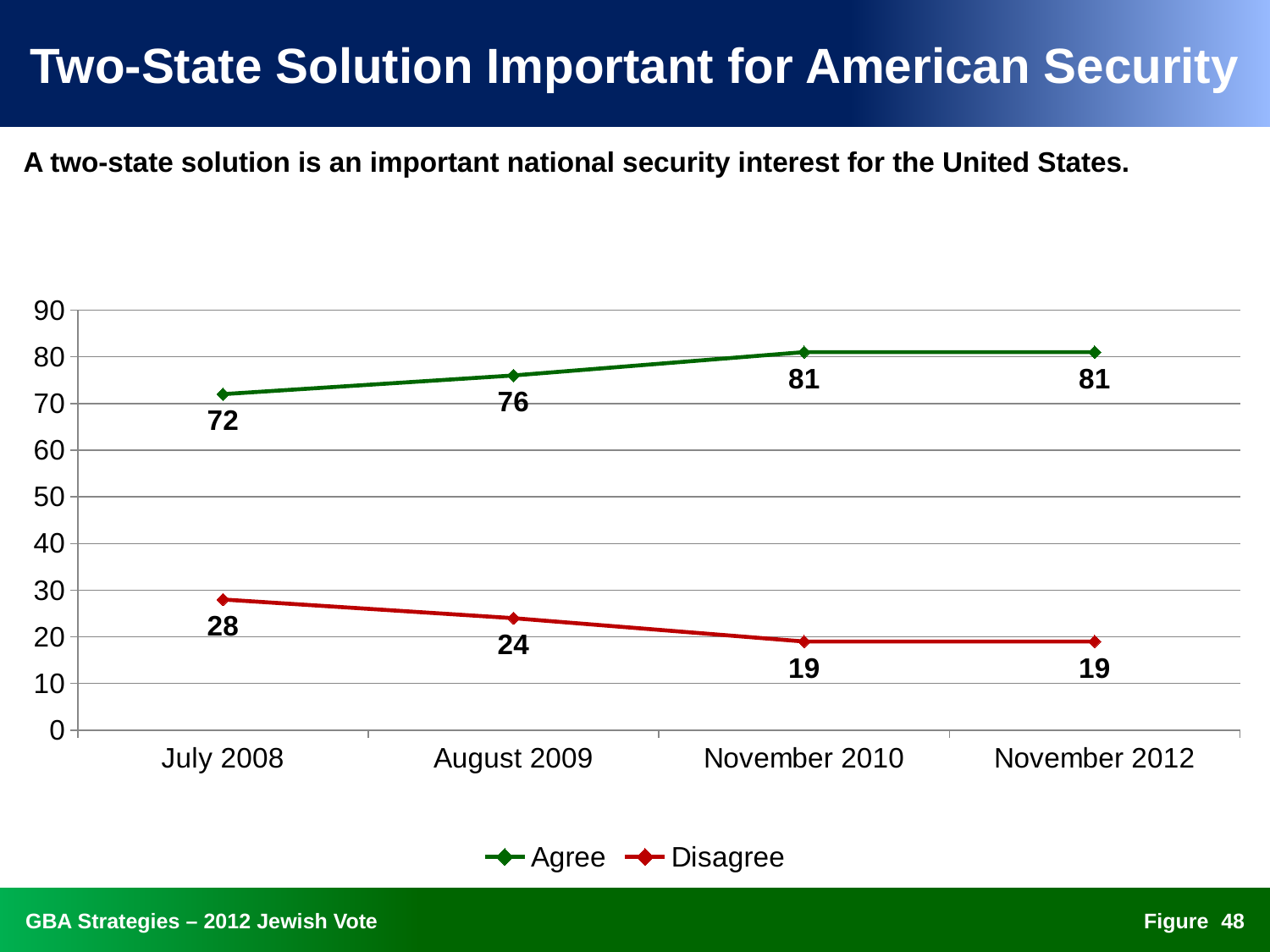
In which survey wave is the Agree value lowest? July 2008 In which survey wave is the Disagree value lowest? November 2010 and November 2012 Does the Disagree series rise or fall from July 2008 to November 2010? Fall What is the Disagree value for August 2009? 24 What is the difference between the Agree and Disagree values in November 2010? 62 By how much did the Agree value change from July 2008 to August 2009? 4 How many survey waves are shown on the x axis? 4 Which is larger in July 2008, the Agree value or the Disagree value? Agree What kind of chart is shown on the slide? Line chart What is the Agree value for November 2012? 81 How many series does the legend list? 2 What is the Agree value for July 2008? 72